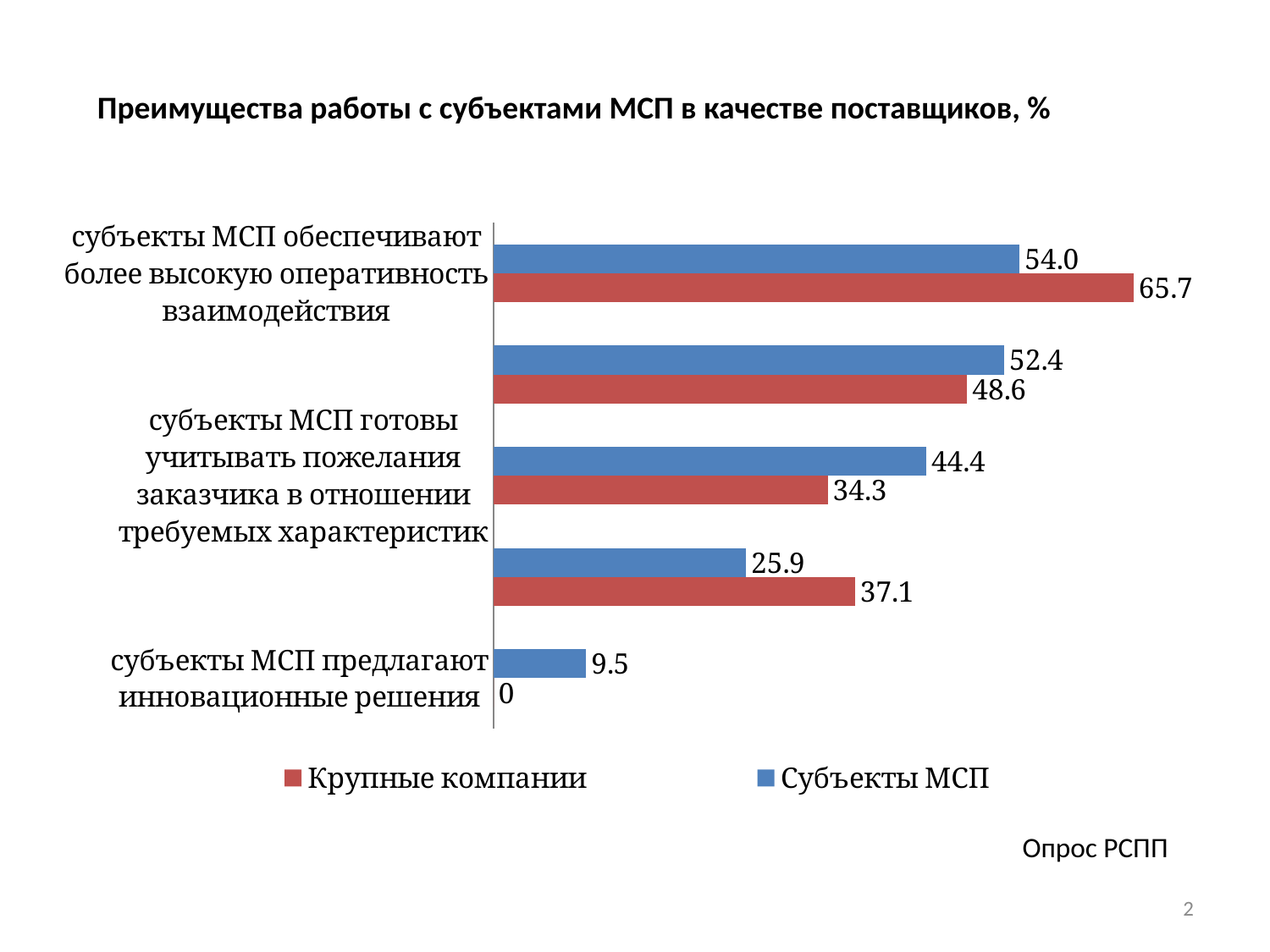
What is the value for Крупные компании for 'субъекты МСП предлагают инновационные решения'? 0 What are the two series named in the legend? Крупные компании, Субъекты МСП What is the value for Субъекты МСП for 'субъекты МСП обеспечивают более высокую оперативность взаимодействия'? 54.0 What is the highest value shown in the chart? 65.7 What is the value for Крупные компании for 'субъекты МСП обеспечивают более высокую оперативность взаимодействия'? 65.7 What is the value for Субъекты МСП for 'субъекты МСП предлагают инновационные решения'? 9.5 How many series does the legend list? 2 What type of chart is shown on the slide? bar chart Which series has the lowest value in the chart, and what is it? Крупные компании, 0 How many groups of bars are plotted in the chart? 5 For 'субъекты МСП обеспечивают более высокую оперативность взаимодействия', which series has the larger value? Крупные компании What is the difference between Крупные компании and Субъекты МСП for 'субъекты МСП обеспечивают более высокую оперативность взаимодействия'? 11.7